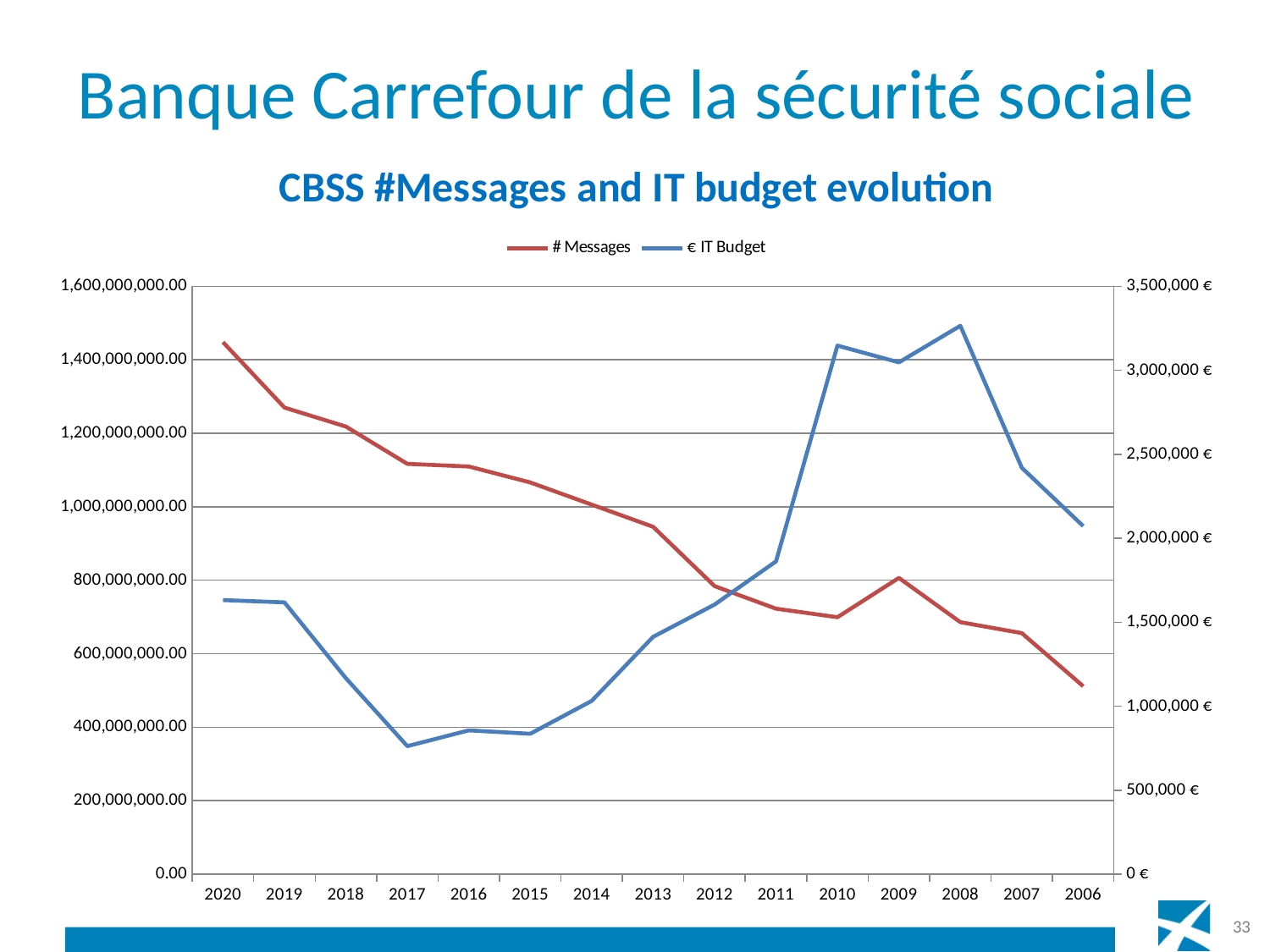
What kind of chart is shown on the slide? line chart How many series does the legend list? 2 Moving left to right along the x axis from 2020 to 2006, does the # Messages series generally rise or fall? fall Is the # Messages value for 2006 greater or less than 600,000,000.00? less What is the title of the chart? CBSS #Messages and IT budget evolution In which year is the # Messages series highest? 2020 How many years are plotted along the x axis? 15 In which year is the € IT Budget series lowest? 2017 Which year has the larger € IT Budget value, 2008 or 2017? 2008 Is the € IT Budget value for 2010 greater or less than 3,000,000 €? greater Is the € IT Budget value for 2017 greater or less than 1,000,000 €? less In which year is the # Messages series lowest? 2006